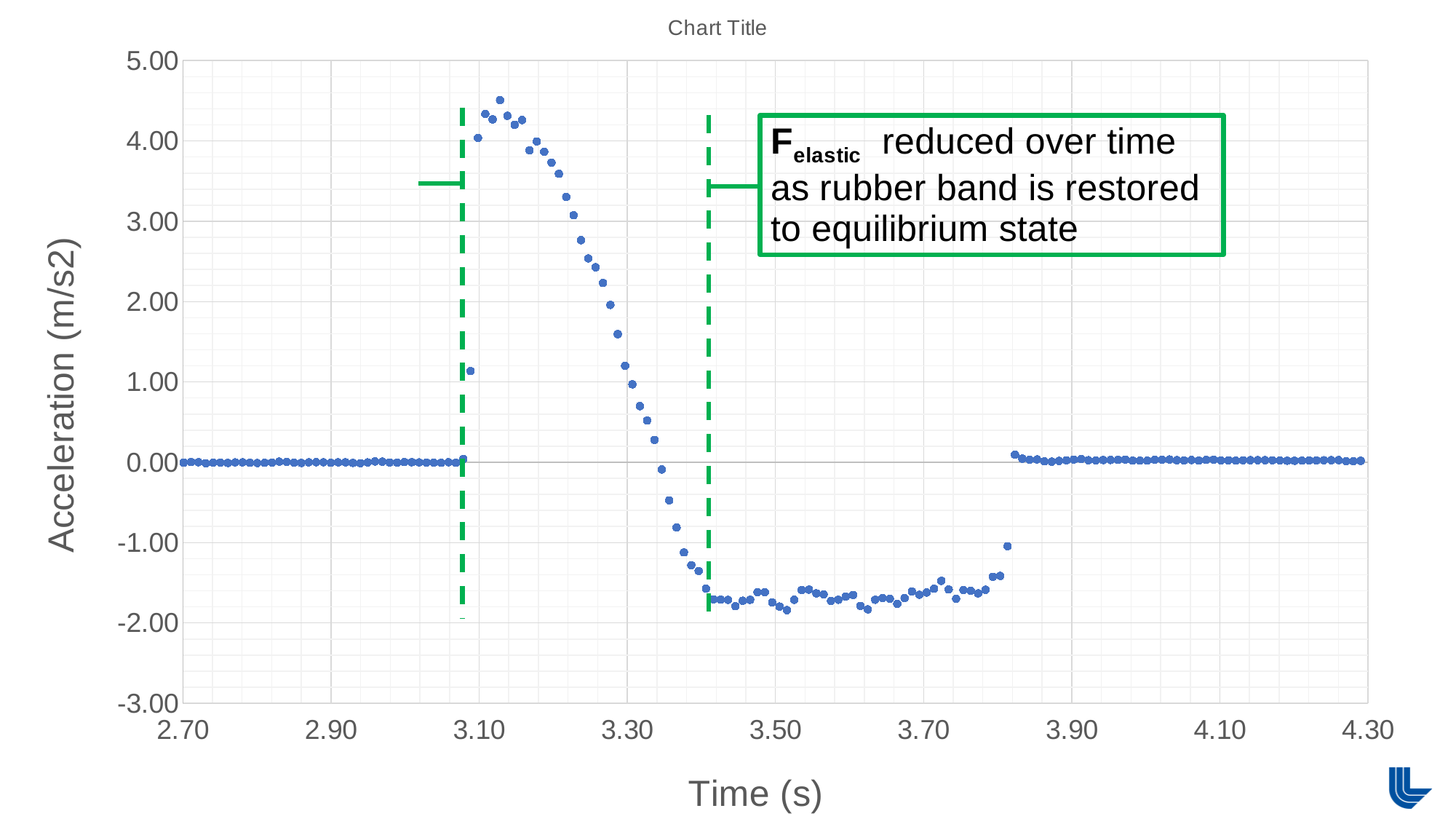
What is the title of the x axis? Time (s) What kind of chart is shown on the slide? scatter chart Is the acceleration at time 4.10 s greater or less than 1.00 m/s2? less Is the highest acceleration value plotted greater or less than 4.00 m/s2? greater Which is larger, the acceleration at time 3.20 s or the acceleration at time 3.60 s? 3.20 s Is the lowest acceleration value plotted greater or less than -1.00 m/s2? less What is the title of the y axis? Acceleration (m/s2) Which is larger, the acceleration at time 3.10 s or the acceleration at time 3.30 s? 3.10 s Between time 3.10 s and 3.40 s, do the acceleration values rise or fall? fall